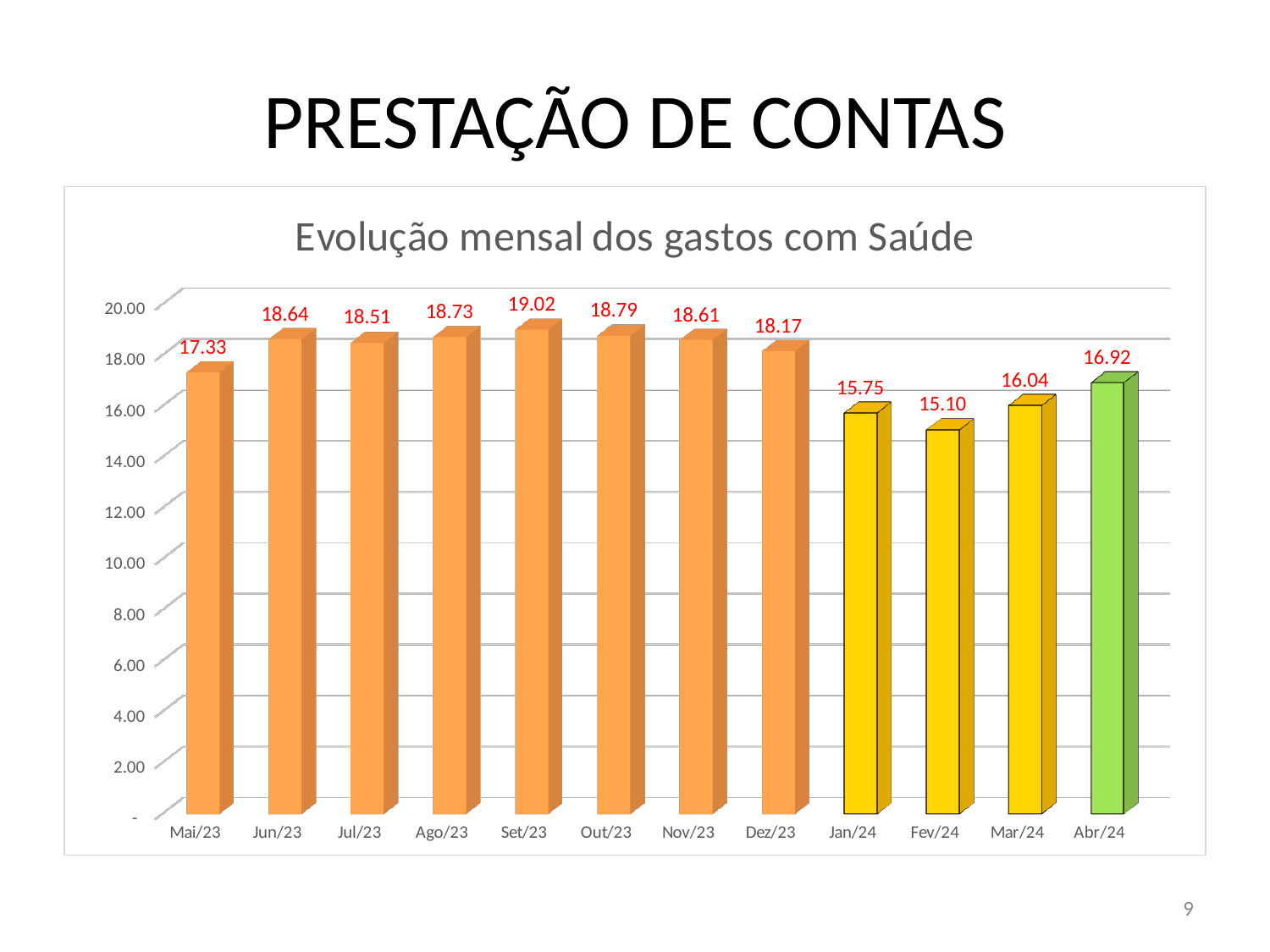
What is the value for Fev/24? 15.10 What kind of chart is this? bar chart How many months are shown on the x axis? 12 What is the difference between the values for Jun/23 and Mai/23? 1.31 Is the value for Abr/24 greater or less than 18.00? less What is the difference between the values for Set/23 and Fev/24? 3.92 Which is larger, the value for Jan/24 or the value for Mar/24? Mar/24 What is the title of the chart? Evolução mensal dos gastos com Saúde What is the value for Set/23? 19.02 Which month has the highest value? Set/23 Which month has the lowest value? Fev/24 What is the value for Mai/23? 17.33